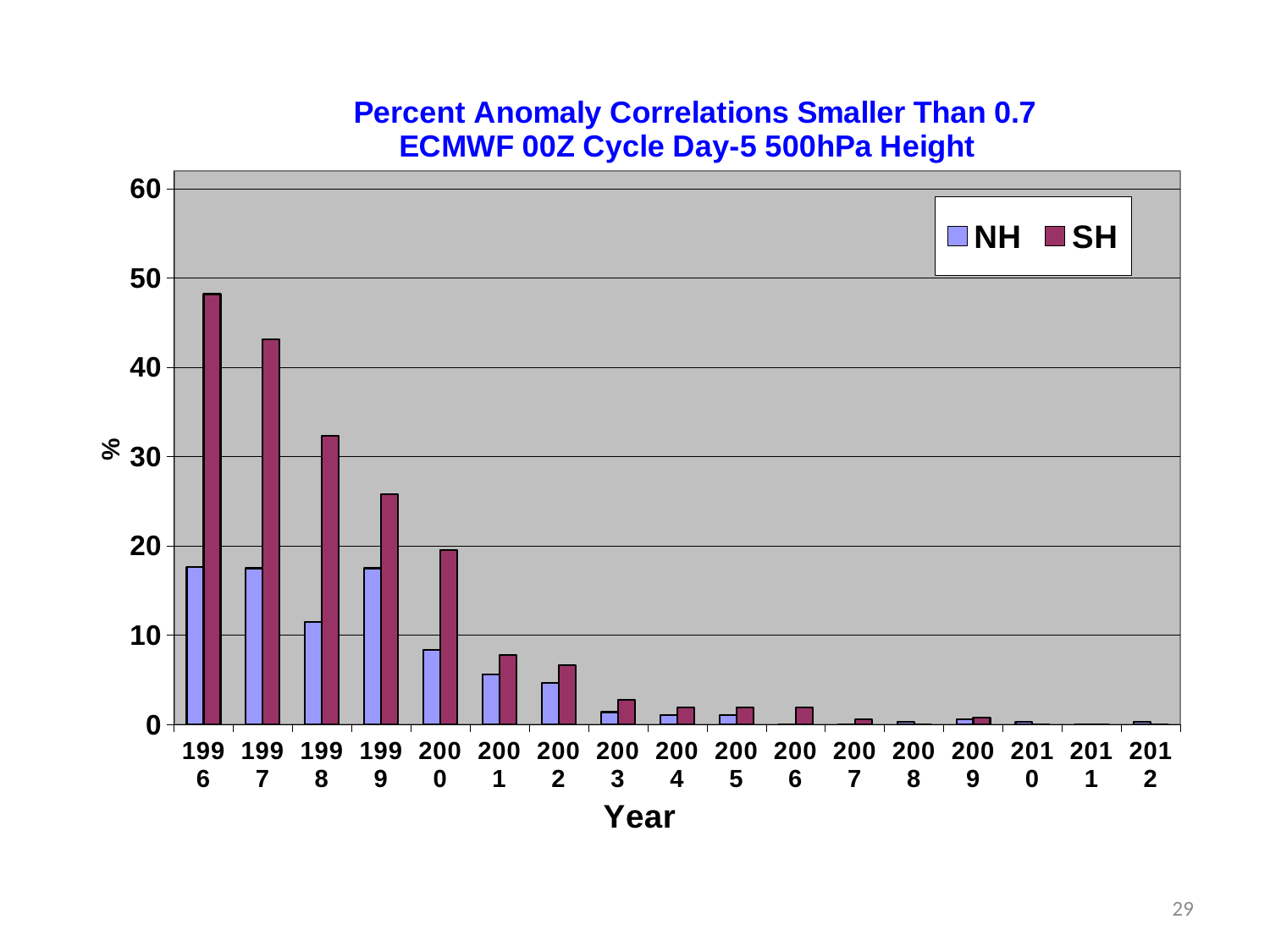
What kind of chart is shown on the slide? bar chart Is the SH value for 1999 greater or less than 20? greater Do the SH values generally rise or fall from 1996 to 2012? fall Is the SH value for 1996 greater or less than 40? greater In 1997, which series has the larger value, NH or SH? SH How many series does the legend list? 2 Is the NH value for 2000 greater or less than 10? less How many years are shown on the x axis? 17 What is the label on the x axis? Year Which year has the highest SH value? 1996